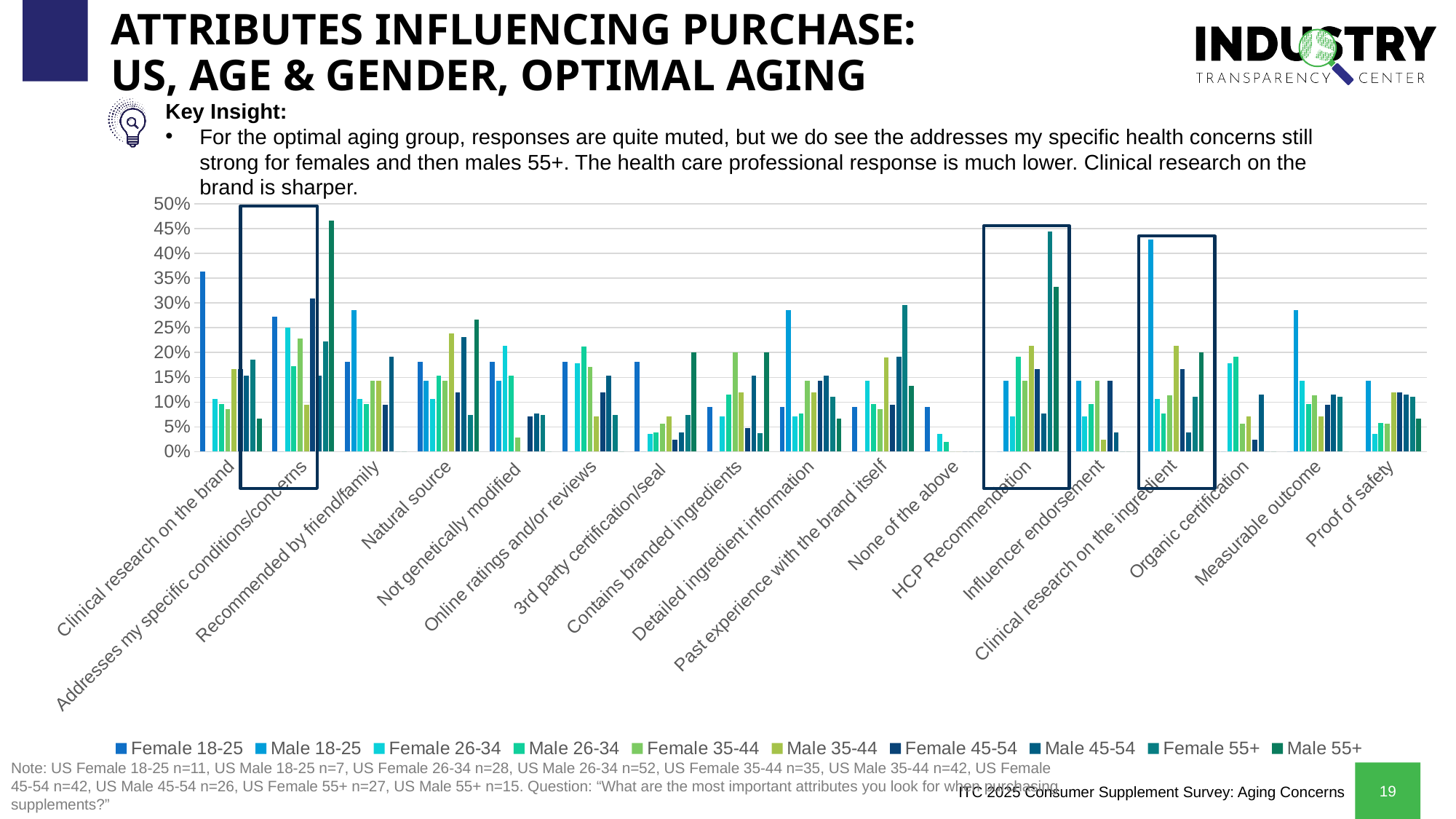
Which series has the highest value for 'HCP Recommendation'? Female 55+ Is the value for Female 18-25 on 'Clinical research on the brand' greater or less than 30%? greater How many series does the legend list? 10 Is the value for Female 55+ on 'HCP Recommendation' greater or less than 40%? greater Is the value for Male 55+ on 'Addresses my specific conditions/concerns' greater or less than 40%? greater Which series has the highest value for 'Addresses my specific conditions/concerns'? Male 55+ How many attribute categories are shown along the x axis? 17 For 'Clinical research on the brand', which is larger: Female 18-25 or Female 26-34? Female 18-25 What kind of chart is shown on the slide? bar chart What is the first series listed in the legend? Female 18-25